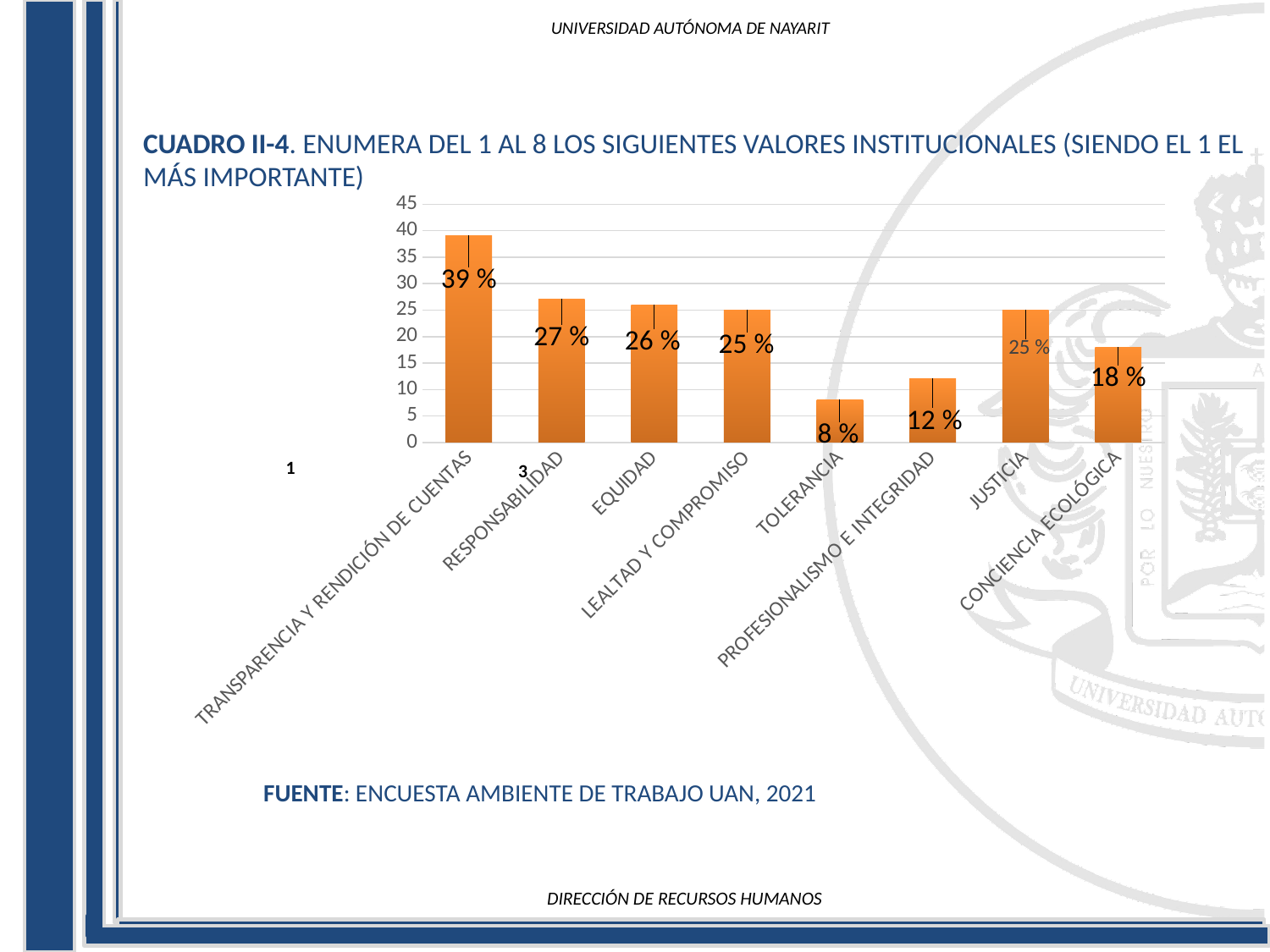
Which category has the highest value in the chart? TRANSPARENCIA Y RENDICIÓN DE CUENTAS Is the value for JUSTICIA greater or less than 20? greater What kind of chart is shown on the slide? bar chart Which is larger, the value for EQUIDAD or the value for PROFESIONALISMO E INTEGRIDAD? EQUIDAD Which category has the lowest value in the chart? TOLERANCIA What is the value shown for TRANSPARENCIA Y RENDICIÓN DE CUENTAS? 39 % What is the value shown for TOLERANCIA? 8 % How many categories (institutional values) are plotted in the chart? 8 What source is cited below the chart? ENCUESTA AMBIENTE DE TRABAJO UAN, 2021 What is the value shown for RESPONSABILIDAD? 27 % What is the value shown for CONCIENCIA ECOLÓGICA? 18 % What is the difference between the values for TRANSPARENCIA Y RENDICIÓN DE CUENTAS and CONCIENCIA ECOLÓGICA? 21 %